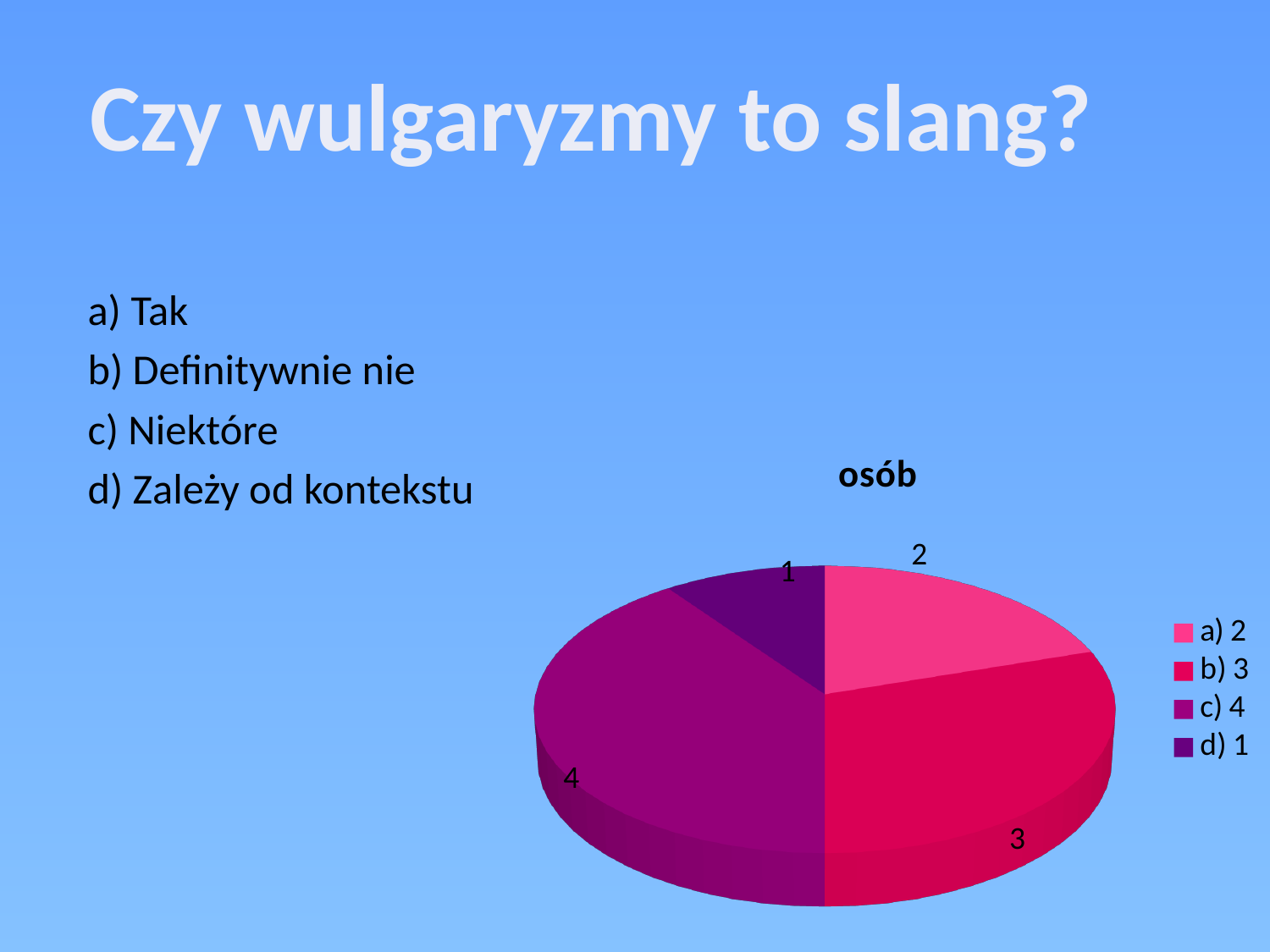
What share of the pie does the slice for answer c) represent? 40% Which is larger, the value for answer b) or the value for answer d)? b) What is the total of all slices in the pie chart? 10 How many slices does the pie chart have? 4 What is the difference between the values for answer c) and answer a)? 2 Which answer has the smallest slice in the pie chart? d) What is the value of the slice for answer a)? 2 Which answer has the largest slice in the pie chart? c) What kind of chart is shown on the slide? pie chart What is the value of the slice for answer c)? 4 What is the title of the chart? osób How many entries does the legend list? 4